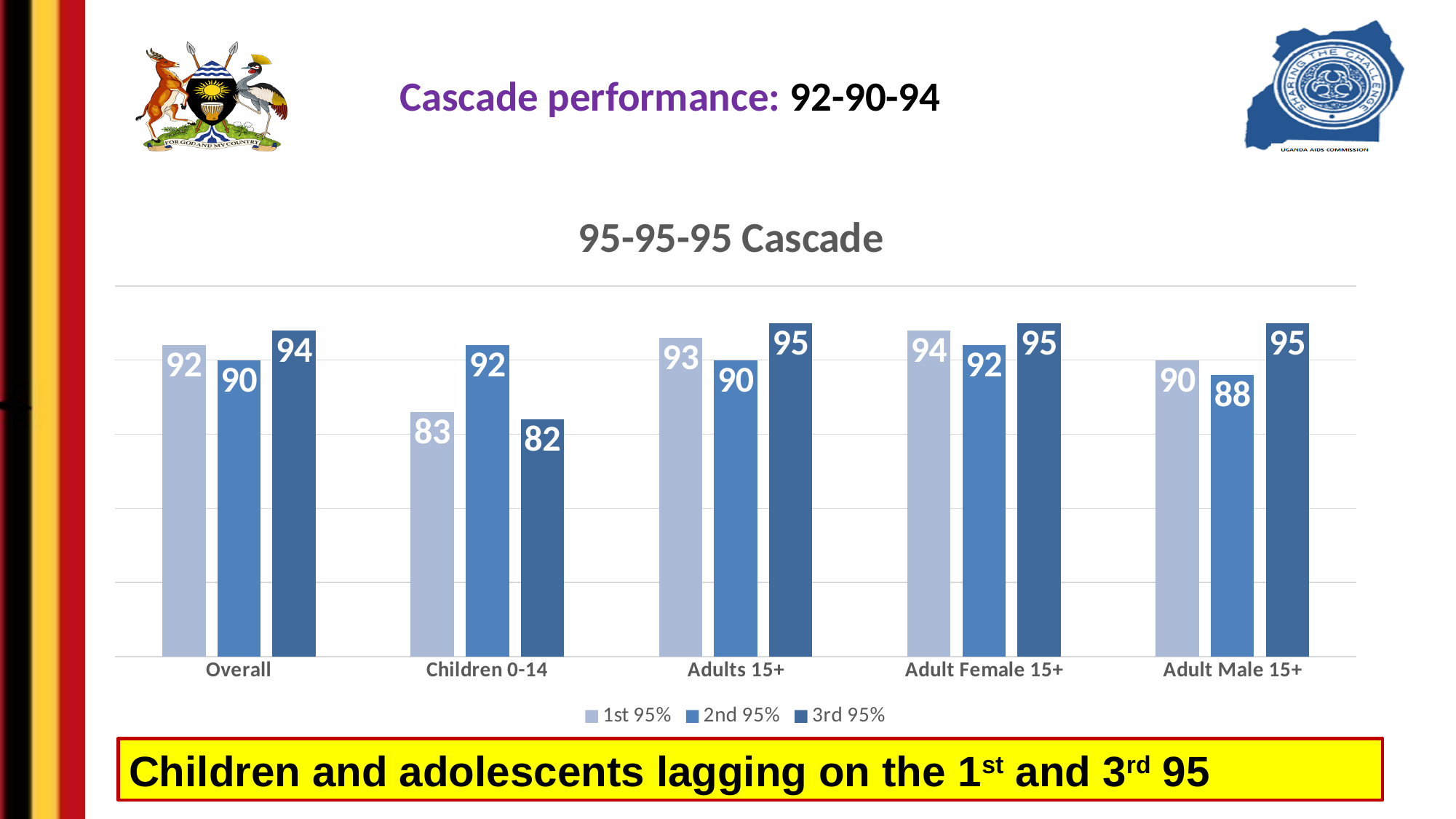
What is the value of the 3rd 95% series for Overall? 94 Which category has the highest value for the 1st 95% series? Adult Female 15+ Which category has the lowest value for the 3rd 95% series? Children 0-14 What is the difference between the 1st 95% values for Adults 15+ and Children 0-14? 10 How many categories are shown on the x axis? 5 What is the value of the 2nd 95% series for Adult Male 15+? 88 What is the difference between the 2nd 95% and 3rd 95% values for Children 0-14? 10 How many series does the legend list? 3 What kind of chart is shown on the slide? Bar chart What is the title of the chart? 95-95-95 Cascade What is the value of the 1st 95% series for Children 0-14? 83 Which is larger for Adult Male 15+: the 1st 95% value or the 2nd 95% value? 1st 95%